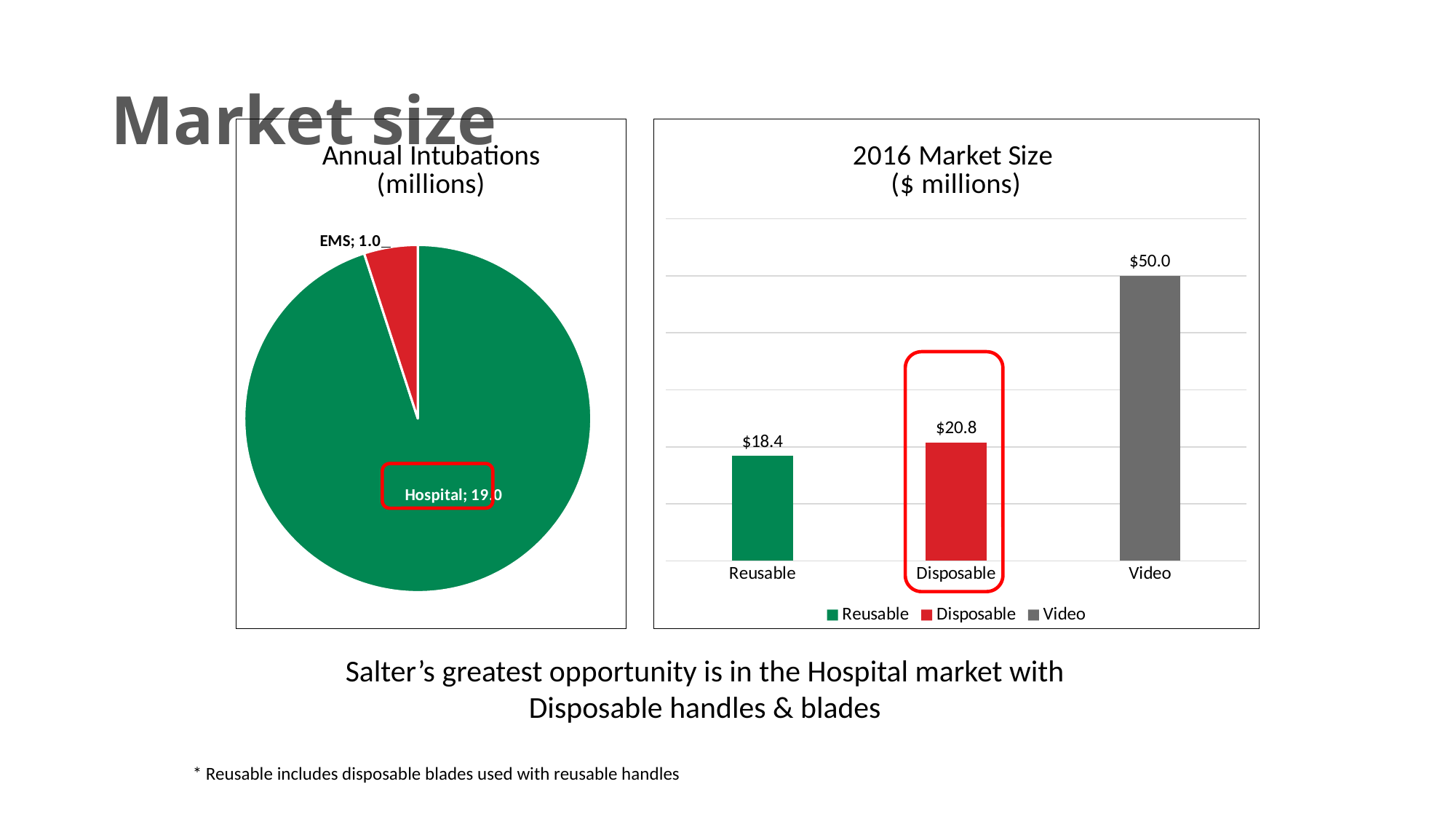
In the 2016 Market Size chart, what is the difference between the Video and Disposable values? $29.2 In the 2016 Market Size chart, which category has the highest value? Video In the 2016 Market Size chart, what is the value for Disposable? $20.8 In the 2016 Market Size chart, how many entries does the legend list? 3 In the Annual Intubations chart, what is the value for EMS? 1.0 In the 2016 Market Size chart, which is larger, Reusable or Disposable? Disposable In the Annual Intubations chart, what share of the total does Hospital represent? 95% In the Annual Intubations chart, what is the value for Hospital? 19.0 In the 2016 Market Size chart, which category has the lowest value? Reusable In the 2016 Market Size chart, how many bars are plotted? 3 What kind of chart is the Annual Intubations chart? Pie chart In the 2016 Market Size chart, what is the value for Video? $50.0